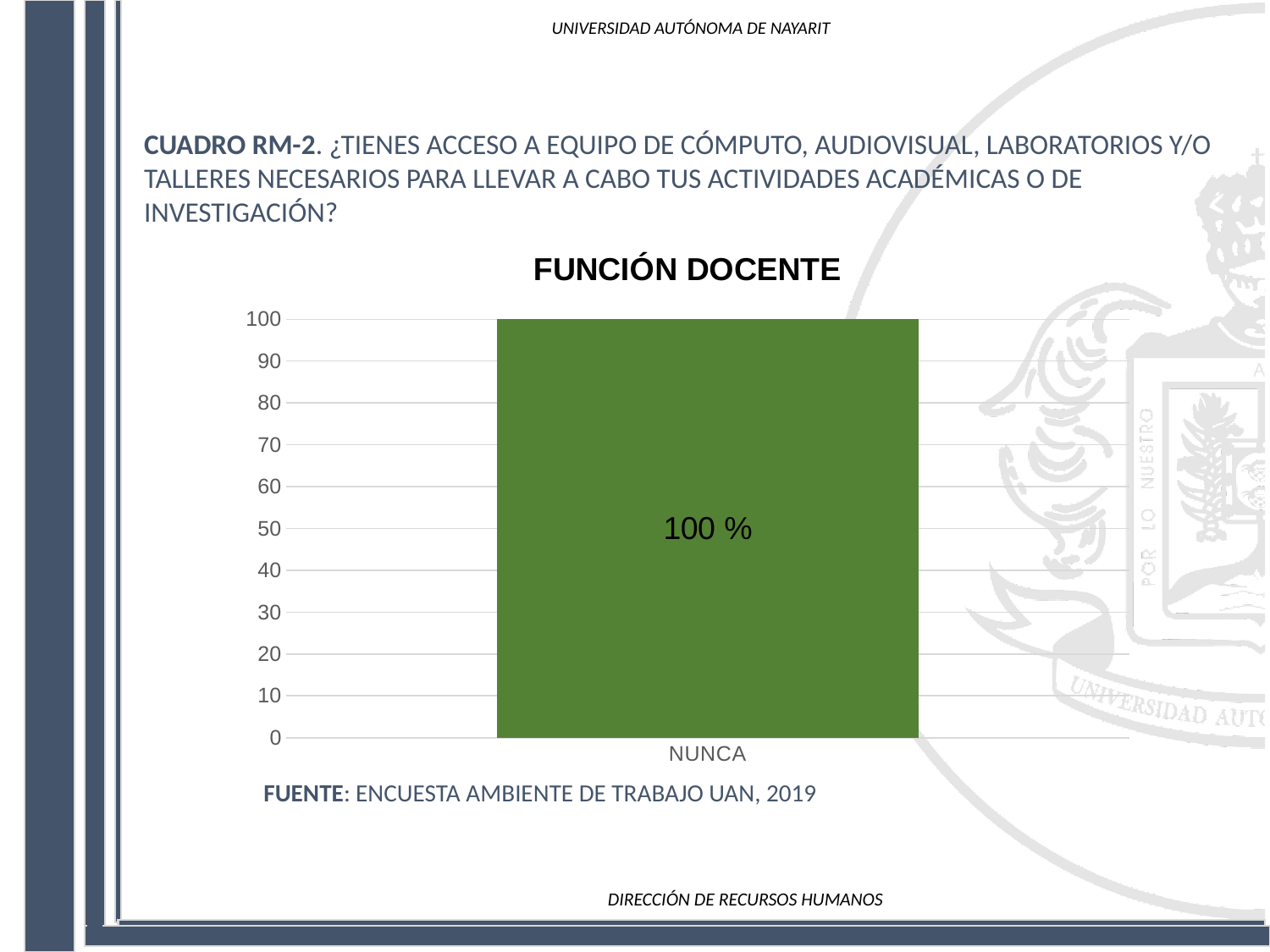
What is the maximum value shown on the y axis? 100 Which category has the highest value in the chart? NUNCA How many categories are plotted on the x axis of the chart? 1 What is the label of the only category on the x axis? NUNCA Is the value for NUNCA greater or less than 50? greater What is the title of the chart? FUNCIÓN DOCENTE What kind of chart is shown on the slide? bar chart What is the value shown for the NUNCA bar? 100 %